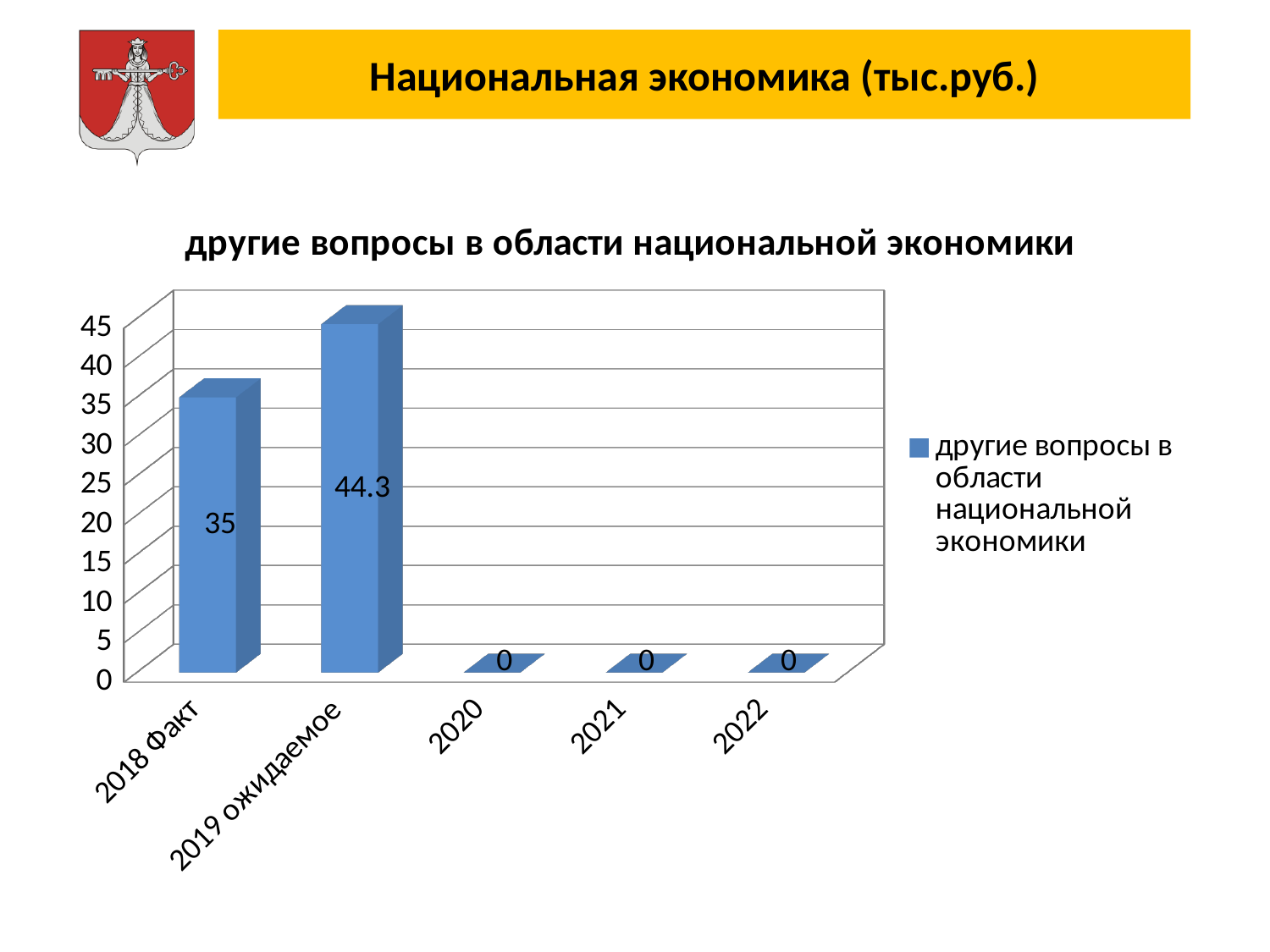
How many series does the legend list? 1 Which category has the highest value? 2019 ожидаемое What is the value for 2020? 0 What is the value for 2018 Факт? 35 What kind of chart is shown? bar chart What is the title of the chart? другие вопросы в области национальной экономики How many categories are shown on the x axis? 5 What is the value for 2019 ожидаемое? 44.3 Is the value for 2019 ожидаемое greater or less than 40? greater Which is larger, the value for 2018 Факт or the value for 2019 ожидаемое? 2019 ожидаемое What is the difference between the values for 2019 ожидаемое and 2018 Факт? 9.3 What is the value for 2022? 0